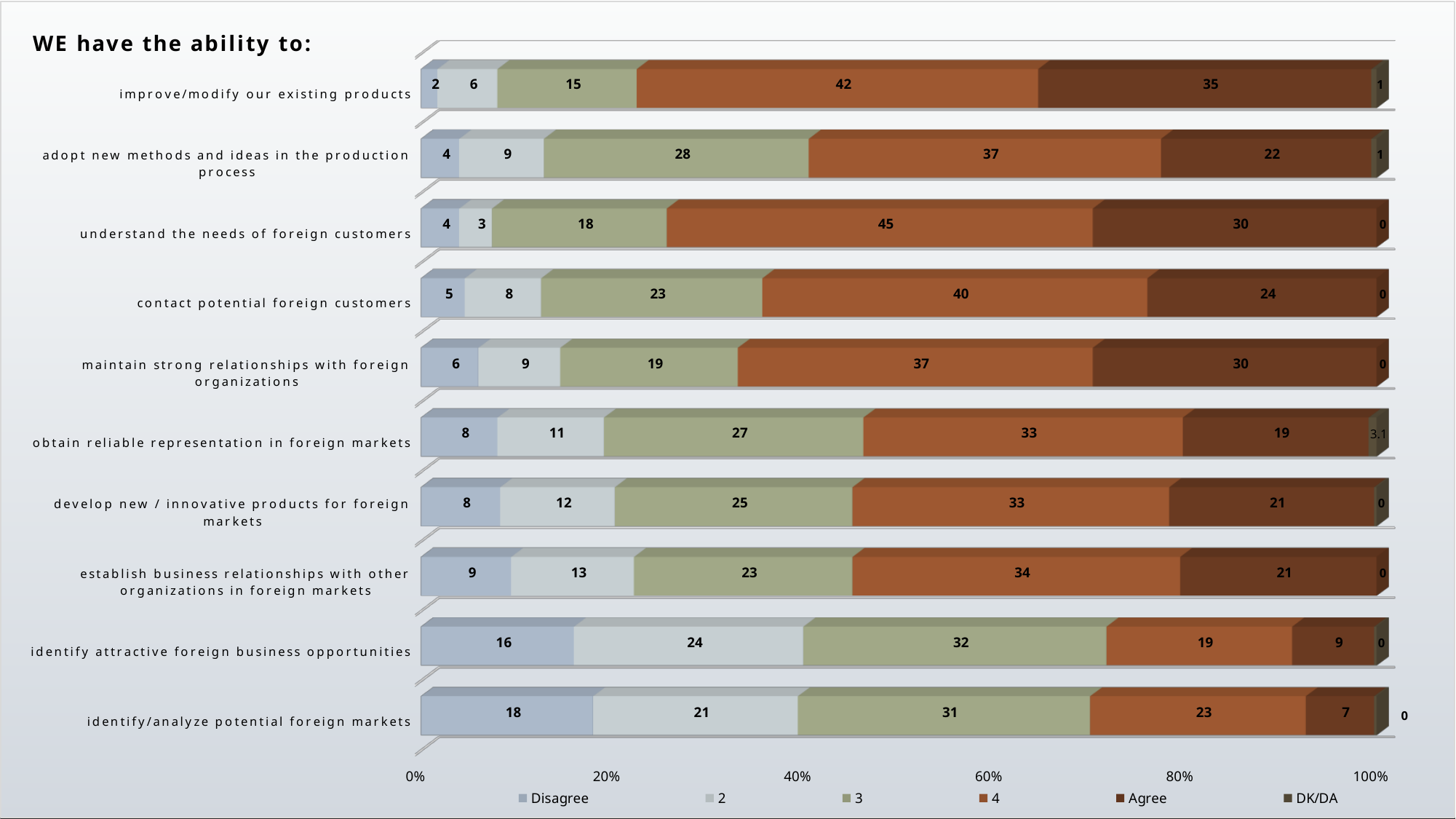
Which has the larger value for series '3': 'adopt new methods and ideas in the production process' or 'understand the needs of foreign customers'? adopt new methods and ideas in the production process What type of chart is shown on the slide? Stacked bar chart Which category has the highest 'Disagree' value? identify/analyze potential foreign markets What is the 'Disagree' value for 'identify/analyze potential foreign markets'? 18 Which category has the lowest 'Agree' value? identify/analyze potential foreign markets How many series does the legend list? 6 What is the title of the chart? WE have the ability to: For 'improve/modify our existing products', what is the difference between the value of series '4' and the 'Agree' value? 7 What is the total of all segments in the bar for 'contact potential foreign customers'? 100 What is the 'Agree' value for 'improve/modify our existing products'? 35 What is the value of series '4' for 'understand the needs of foreign customers'? 45 How many categories (abilities) are plotted on the chart? 10